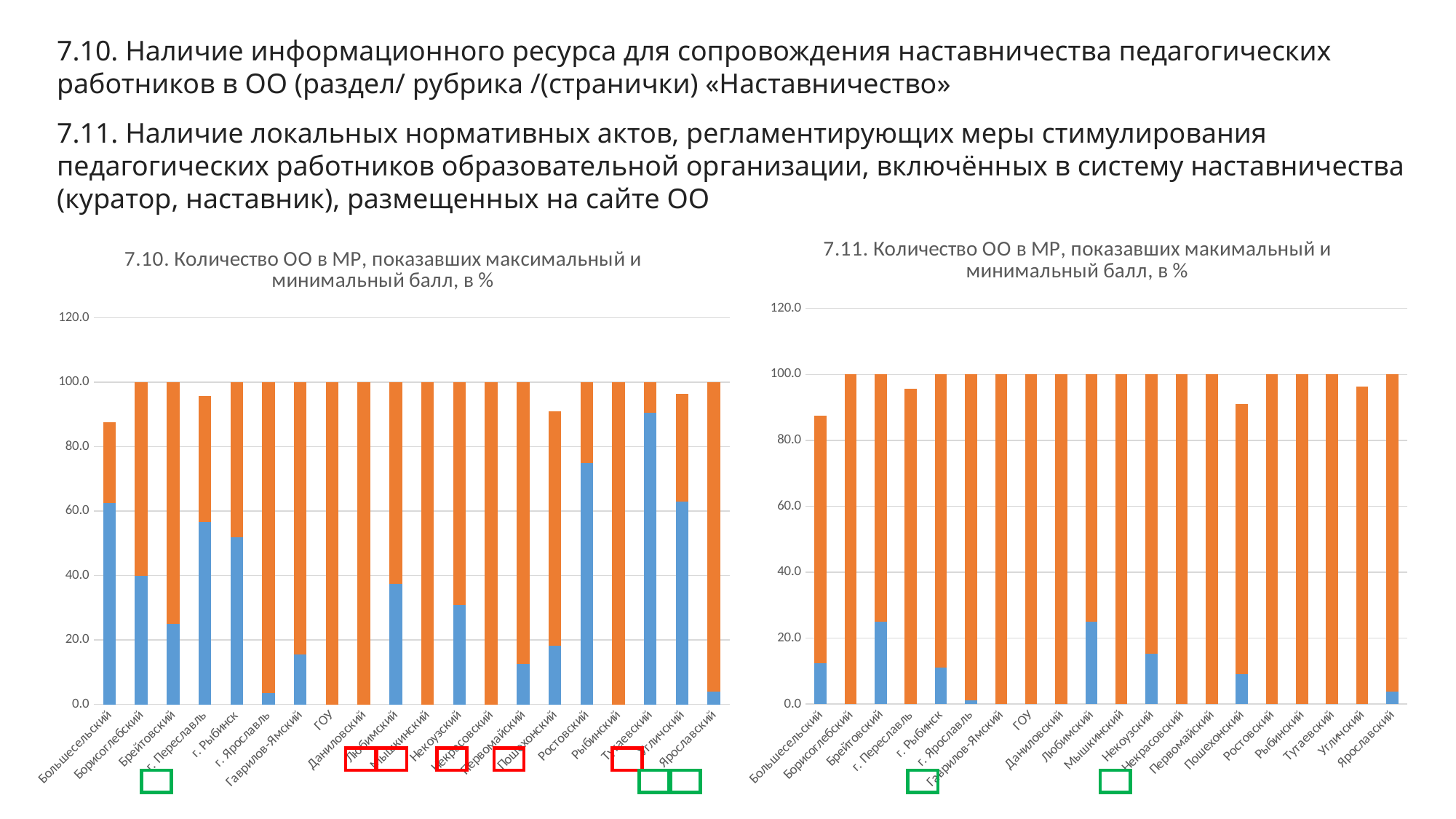
In the right chart (7.11), which has the larger blue segment, Брейтовский or Некоузский? Брейтовский In the left chart (7.10), how many categories are shown on the x axis? 20 In the left chart (7.10), is the total height of the bar for Большесельский greater or less than 100? less In the left chart (7.10), which category has the tallest blue segment? Тутаевский In the right chart (7.11), how many categories are shown on the x axis? 20 What kind of chart is the left chart titled "7.10. Количество ОО в МР, показавших максимальный и минимальный балл, в %"? Stacked bar chart In the right chart (7.11), is the total height of the bar for Пошехонский greater or less than 100? less In the right chart (7.11), is the blue segment for Брейтовский greater or less than 20? greater In the left chart (7.10), which has the larger blue segment, Тутаевский or Ростовский? Тутаевский What is the highest value shown on the vertical axis of the right chart (7.11)? 120.0